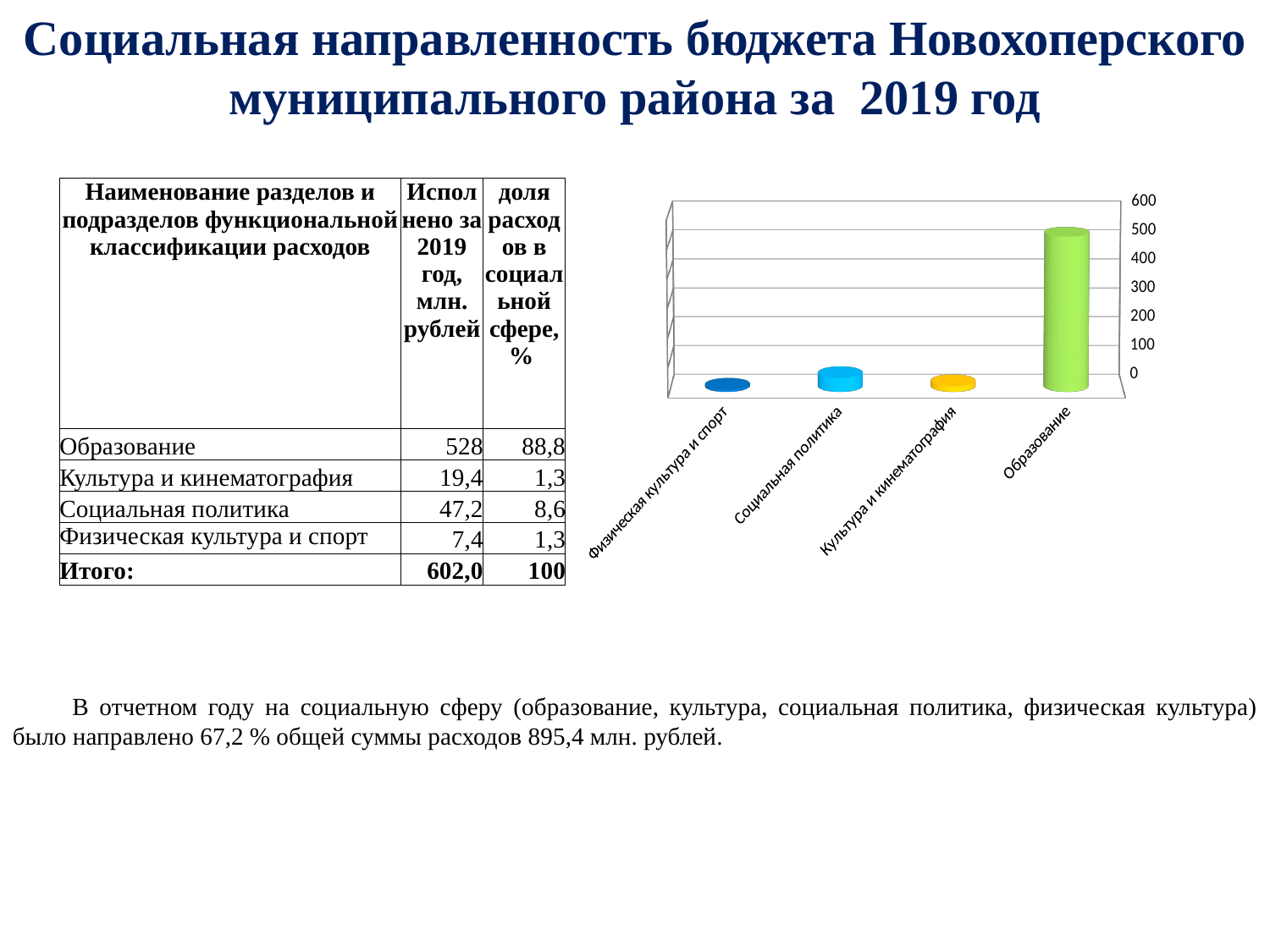
Is the value for Образование in the chart greater or less than 500? greater Is the value for Социальная политика in the chart greater or less than 100? less According to the table, what is the value for Социальная политика in 2019, in million rubles? 47,2 How many categories are plotted in the bar chart? 4 Which is larger in the chart, Социальная политика or Культура и кинематография? Социальная политика What kind of chart is shown on the slide? bar chart According to the table, what is the value for Образование in 2019, in million rubles? 528 Is the value for Культура и кинематография in the chart greater or less than 100? less Which is larger in the chart, Образование or Социальная политика? Образование Which category has the lowest bar in the chart? Физическая культура и спорт Which category has the highest bar in the chart? Образование What is the highest tick value shown on the chart's vertical axis? 600